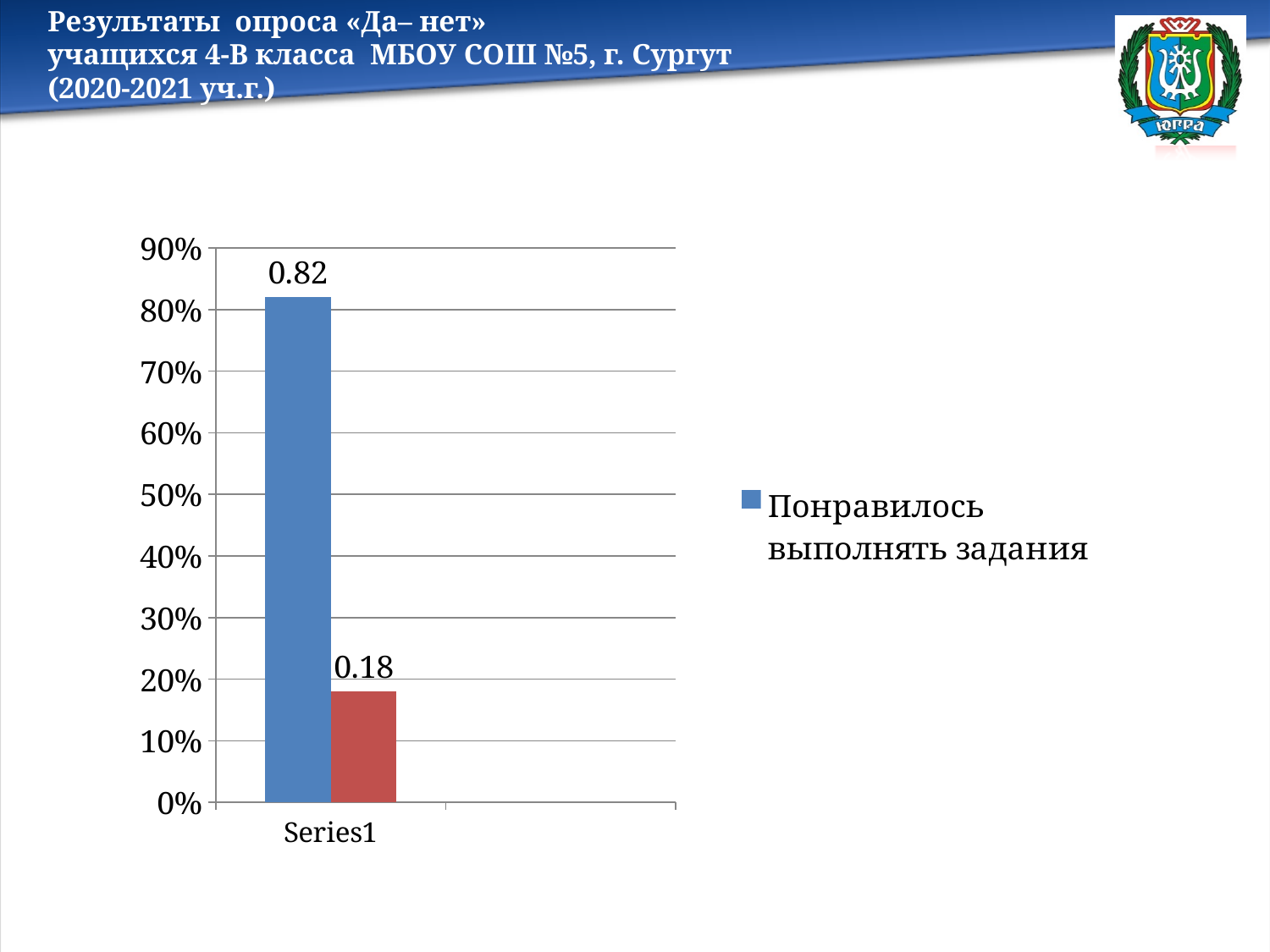
Which bar is the tallest in the chart? the blue bar (Понравилось выполнять задания) What is the difference between the values printed on the blue bar and the red bar? 0.64 What is the category label shown on the x axis of the chart? Series1 How many entries does the chart legend list? 1 Is the blue bar greater or less than 50%? greater What kind of chart is shown on the slide? bar chart What value is printed on the red bar? 0.18 Which bar is the shortest in the chart? the red bar (0.18) Is the red bar greater or less than 30%? less What value is printed on the blue bar (Понравилось выполнять задания)? 0.82 How many bars are plotted in the chart? 2 Which is larger, the value of the blue bar or the value of the red bar? the blue bar